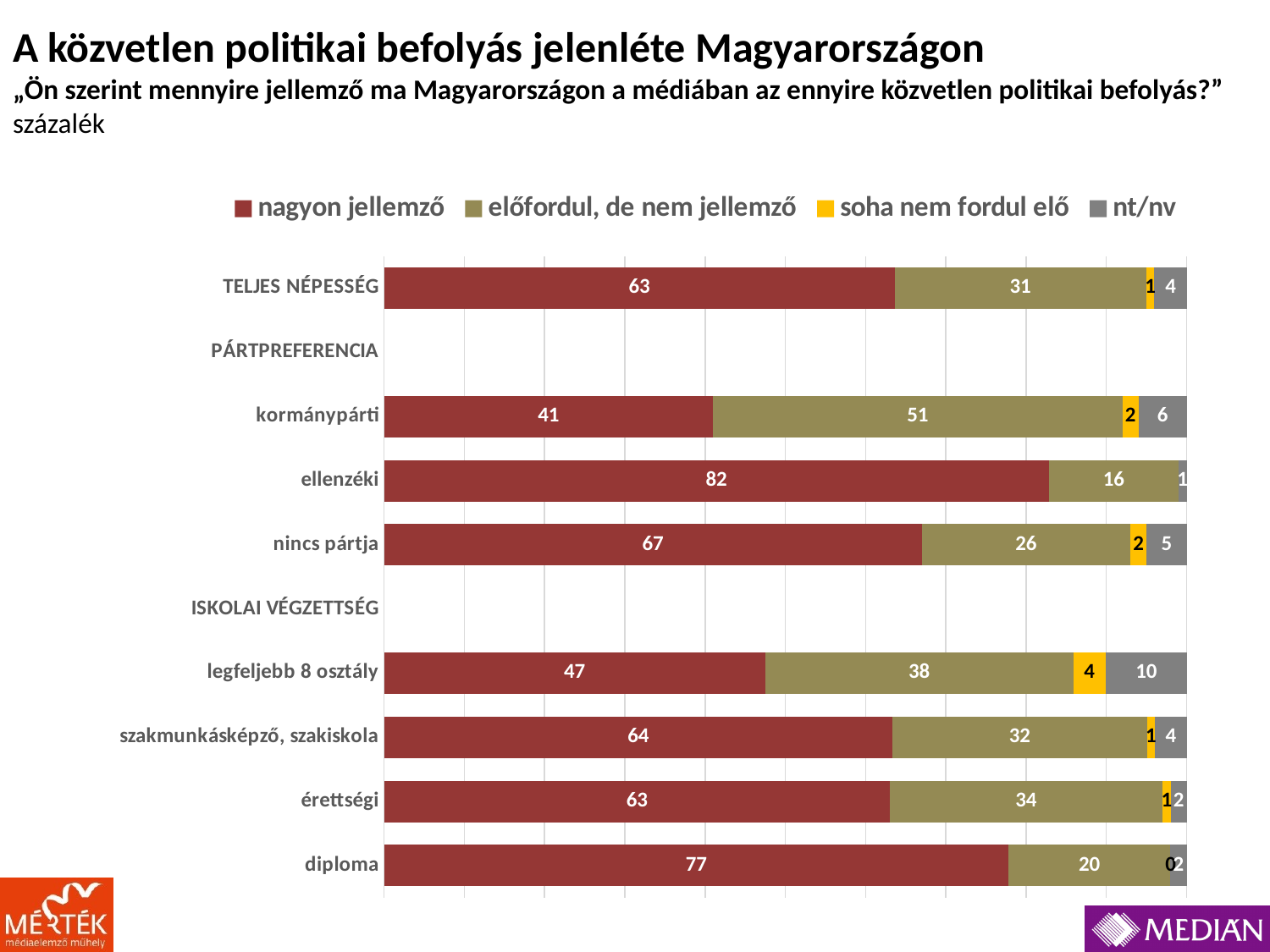
What is the total of the stacked bar for TELJES NÉPESSÉG? 99 What is the value of "nagyon jellemző" for kormánypárti? 41 Which category has the highest "nagyon jellemző" value? ellenzéki What is the "nt/nv" value for legfeljebb 8 osztály? 10 Which category has the highest "nt/nv" value? legfeljebb 8 osztály Which category has the lowest "nagyon jellemző" value? kormánypárti How many series does the legend list? 4 What is the "soha nem fordul elő" value for nincs pártja? 2 What kind of chart is shown on the slide? stacked bar chart What is the value of "előfordul, de nem jellemző" for legfeljebb 8 osztály? 38 What is the difference between the "nagyon jellemző" values for ellenzéki and kormánypárti? 41 Which has a larger "nagyon jellemző" value, diploma or érettségi? diploma